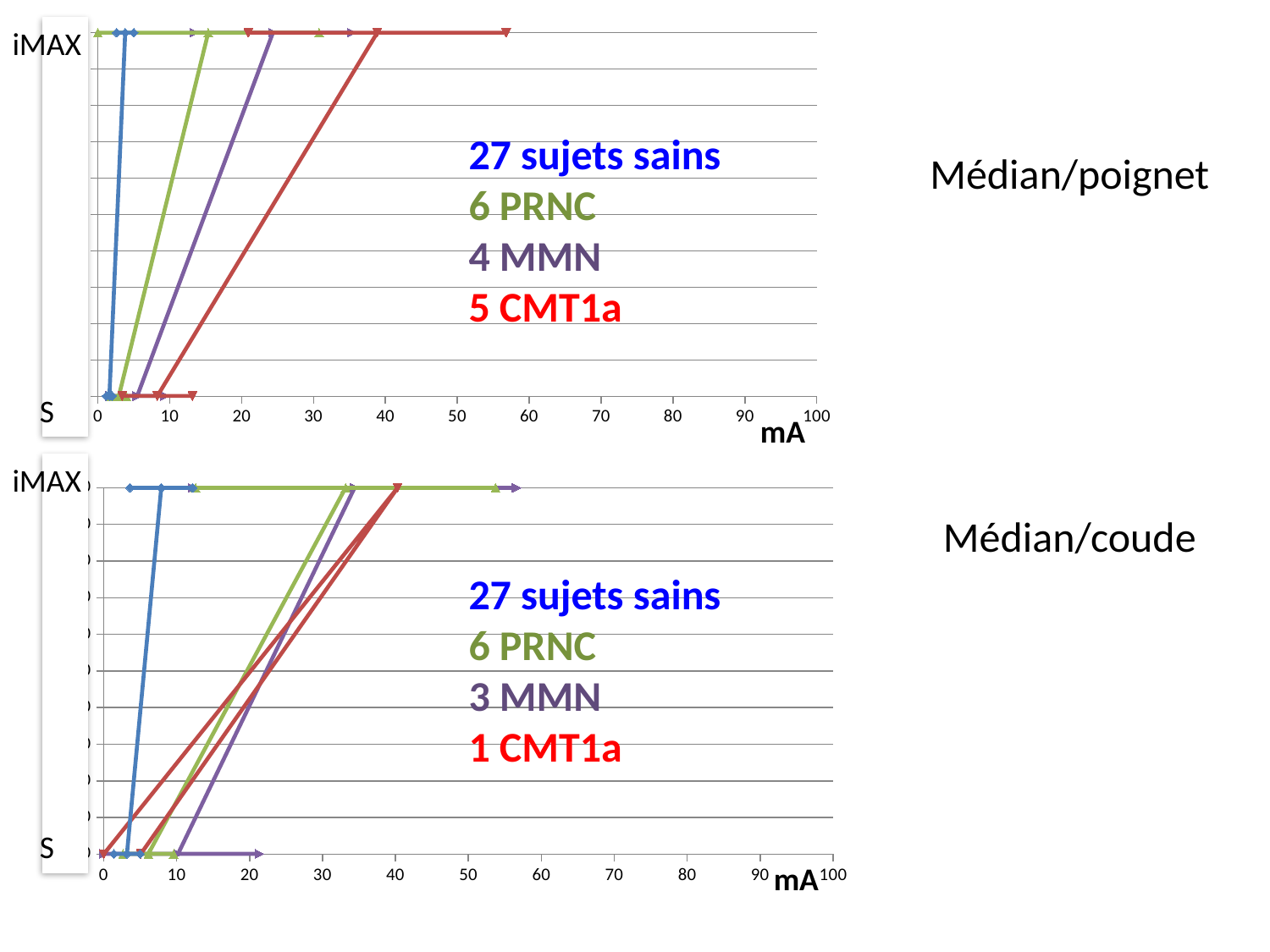
In the Médian/poignet chart, which group reaches iMAX at a higher current, PRNC or CMT1a? CMT1a What kind of chart is the Médian/poignet chart? line chart In the Médian/poignet chart, how many CMT1a subjects are listed? 5 In the Médian/poignet chart, which group's line reaches iMAX at the highest current? CMT1a What is the title of the bottom chart? Médian/coude In the Médian/coude chart, how many MMN subjects are listed? 3 In the Médian/coude chart, does the purple MMN line reach iMAX at a current greater or less than 20 mA? greater In the Médian/poignet chart, does the red CMT1a line reach iMAX at a current greater or less than 30 mA? greater In the Médian/poignet chart, how many subject groups are listed? 4 What unit is shown on the x axis of both charts? mA In the Médian/poignet chart, does the blue sujets sains line reach iMAX at a current greater or less than 10 mA? less In the Médian/coude chart, how many CMT1a subjects are listed? 1